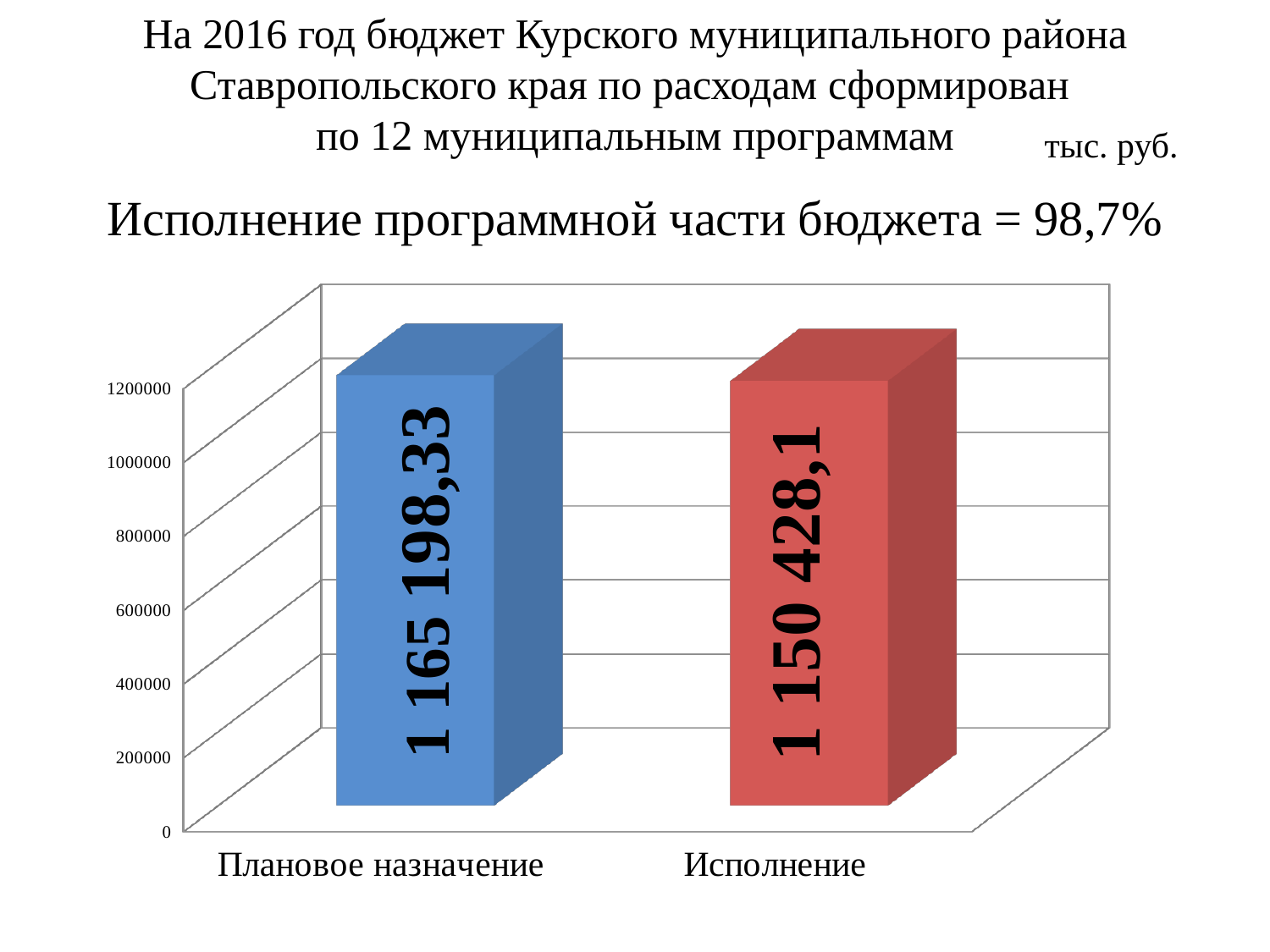
How many categories are shown on the chart? 2 Which category has the higher value, Плановое назначение or Исполнение? Плановое назначение Is the value for Плановое назначение greater or less than 800000? greater What colour is the bar for Исполнение? red Which category has the lowest value? Исполнение What unit of measurement is indicated for the chart values? тыс. руб. What is the difference between the values for Плановое назначение and Исполнение? 14 770,23 What is the value for Исполнение? 1 150 428,1 Is the value for Исполнение greater or less than 1000000? greater What is the value for Плановое назначение? 1 165 198,33 What kind of chart is shown on the slide? bar chart Which category has the highest value? Плановое назначение